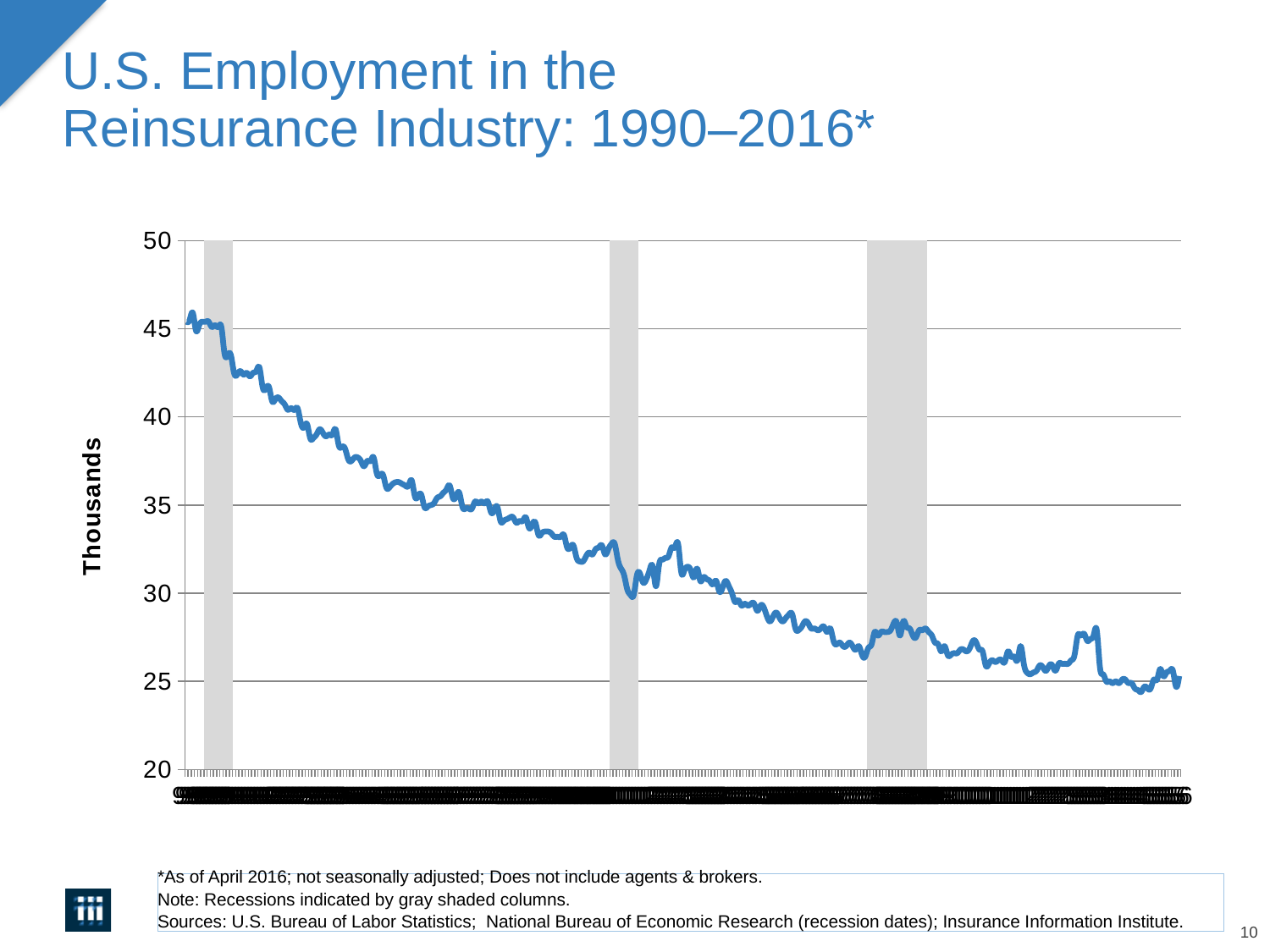
What kind of chart is shown on the slide? line chart Is the value at the end of the series (2016) greater or less than 30? less Which is larger, the value at the start of the series or the value at the end of the series? the value at the start How many lines are plotted on the chart? 1 What is the label on the vertical axis of the chart? Thousands Is the value at the end of the series (2016) greater or less than 20? greater Overall, do the values rise or fall from left to right along the x axis? fall What is the highest value shown on the vertical axis? 50 What is the title of the chart on the slide? U.S. Employment in the Reinsurance Industry: 1990–2016* How many gray shaded recession columns are shown on the chart? 3 Is the value at the start of the series (1990) greater or less than 50? less